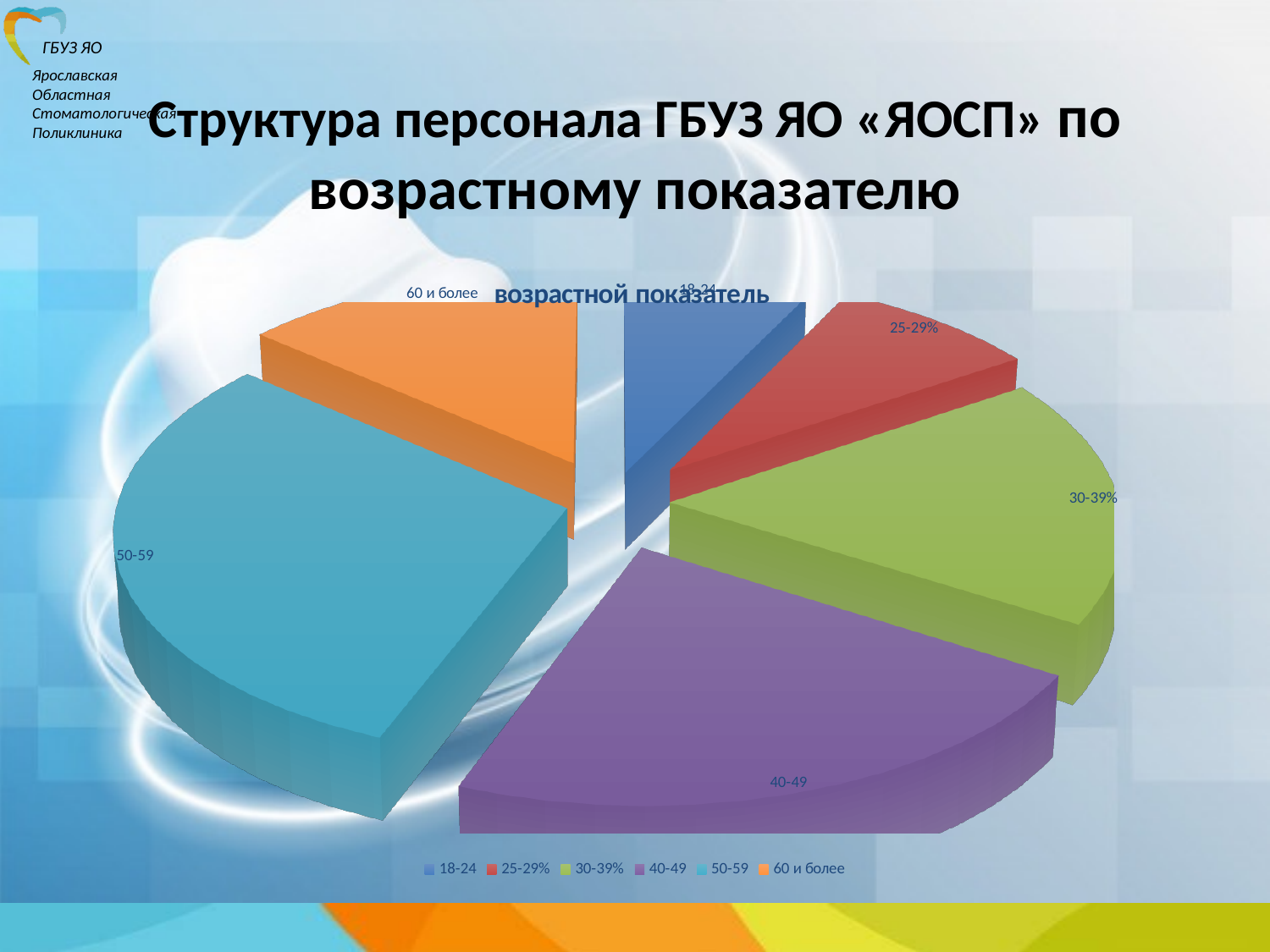
Which slice is larger, 30-39% or 25-29%? 30-39% How many entries does the legend of the pie chart list? 6 Which age category has the largest slice of the pie chart? 50-59 Which slice is larger, 60 и более or 25-29%? 60 и более Which slice is larger, 40-49 or 18-24? 40-49 What kind of chart is shown on the slide? pie chart How many slices does the pie chart have? 6 What is the title of the pie chart? возрастной показатель What colour is the 40-49 slice of the pie chart? purple